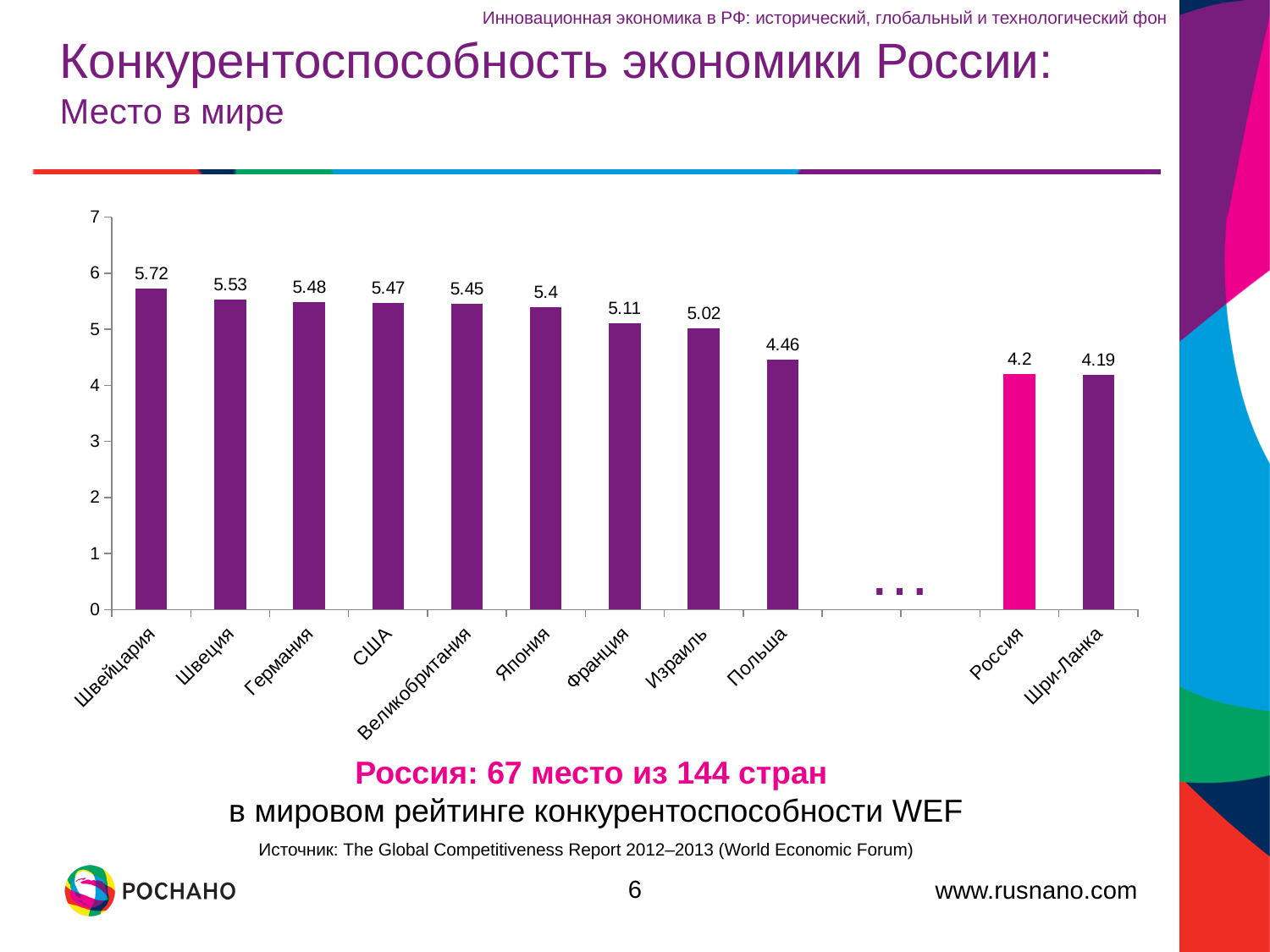
What is the value shown for Швейцария? 5.72 Is the value for Польша greater or less than 5? less What kind of chart is shown on the slide? bar chart What is the value shown for Россия? 4.2 What is the value shown for Польша? 4.46 Which country has the lowest value in the chart? Шри-Ланка Which country has the highest value in the chart? Швейцария What is the difference between the values for Швейцария and Россия? 1.52 Which country's bar is drawn in a different colour (pink) from the others? Россия What is the difference between the values for Польша and Россия? 0.26 Which has a larger value, Япония or Франция? Япония How many countries have bars in the chart? 11